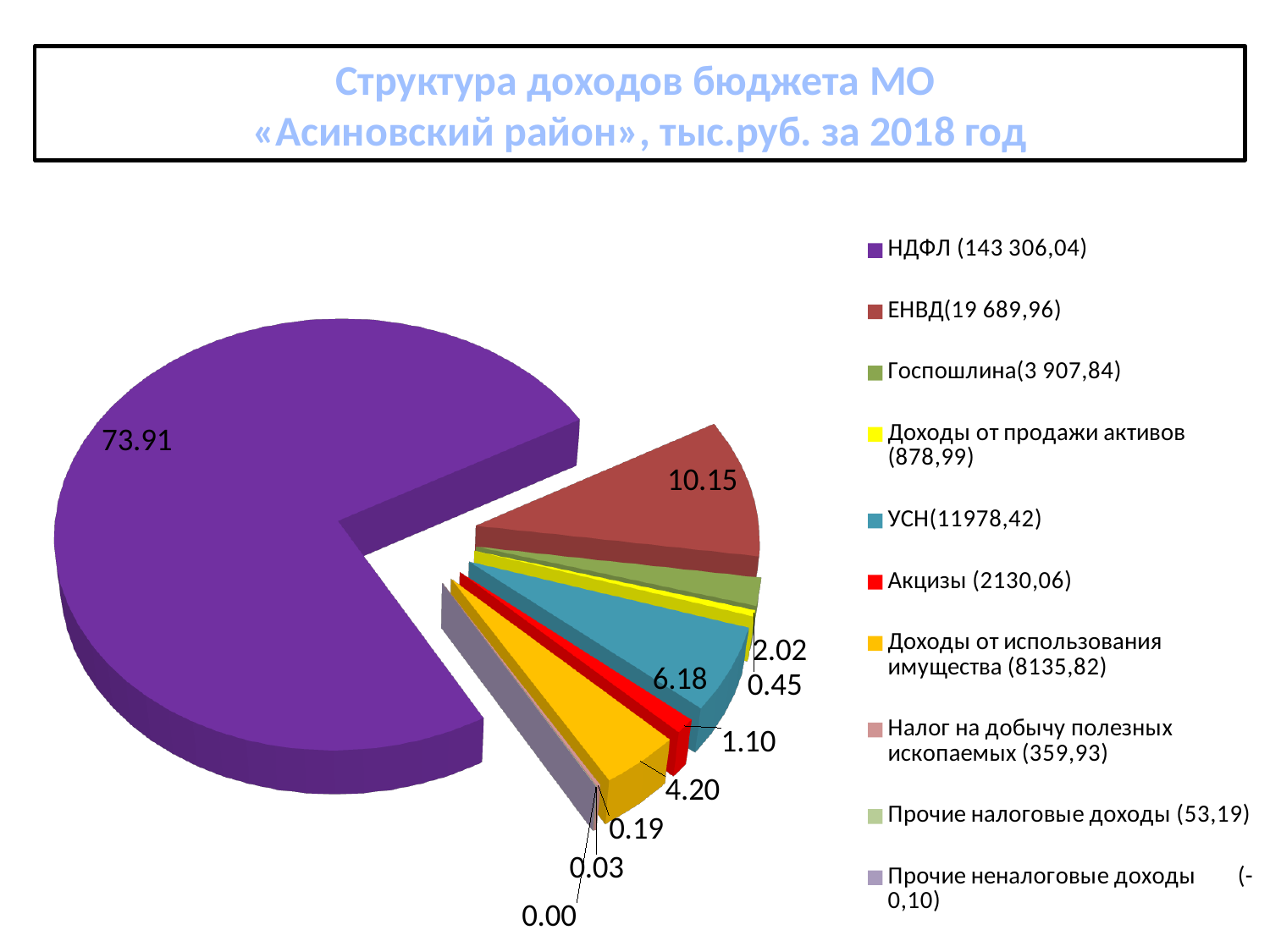
What type of chart is shown on the slide? pie chart What is the data label shown for the УСН slice? 6.18 What value in thousand rubles does the legend give for НДФЛ? 143 306,04 Which category has the largest slice of the pie? НДФЛ Which slice is larger, Акцизы or Госпошлина? Госпошлина What is the data label shown for the НДФЛ slice? 73.91 Which category has the smallest slice of the pie? Прочие неналоговые доходы What is the data label shown for the Доходы от использования имущества slice? 4.20 What is the title of the chart on the slide? Структура доходов бюджета МО «Асиновский район», тыс.руб. за 2018 год What is the data label shown for the ЕНВД slice? 10.15 What is the difference between the data labels for ЕНВД and УСН? 3.97 How many categories does the legend of the pie chart list? 10